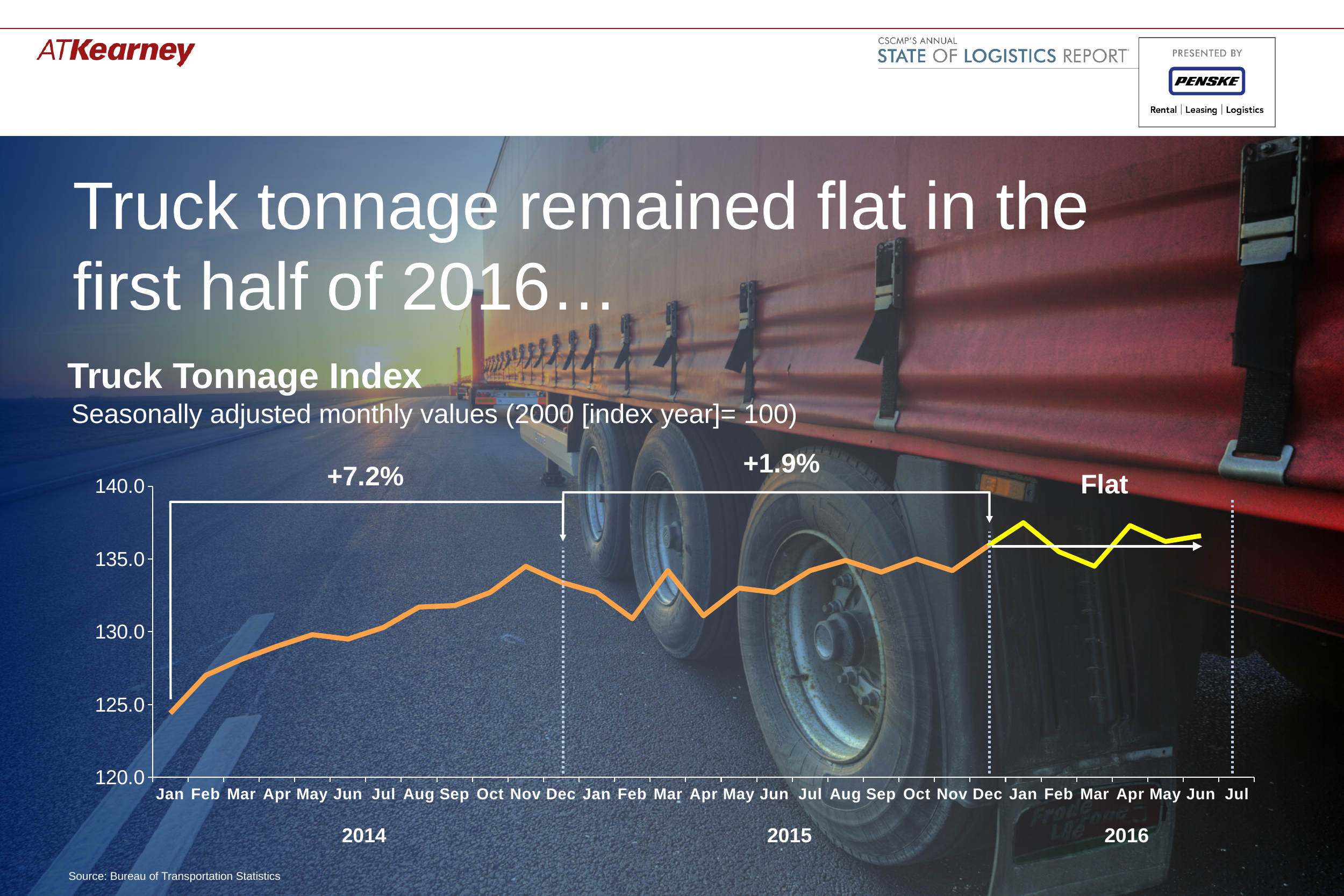
What percentage change is annotated for the Truck Tonnage Index over 2014? +7.2% What percentage change is annotated for the Truck Tonnage Index over 2015? +1.9% What is the title of the chart? Truck Tonnage Index What is the source cited for the chart? Bureau of Transportation Statistics Is the Truck Tonnage Index value for Jan 2014 greater or less than 130? less Which month has the lowest Truck Tonnage Index value on the chart? Jan 2014 Which is larger, the Truck Tonnage Index value for Dec 2014 or for Dec 2015? Dec 2015 Is the Truck Tonnage Index value for Mar 2014 greater or less than 130? less Is the Truck Tonnage Index value for Jan 2016 greater or less than 135? greater How is the change in the Truck Tonnage Index during the first half of 2016 labelled on the chart? Flat Does the Truck Tonnage Index generally rise or fall over the course of 2014? rise What kind of chart is shown on the slide? line chart